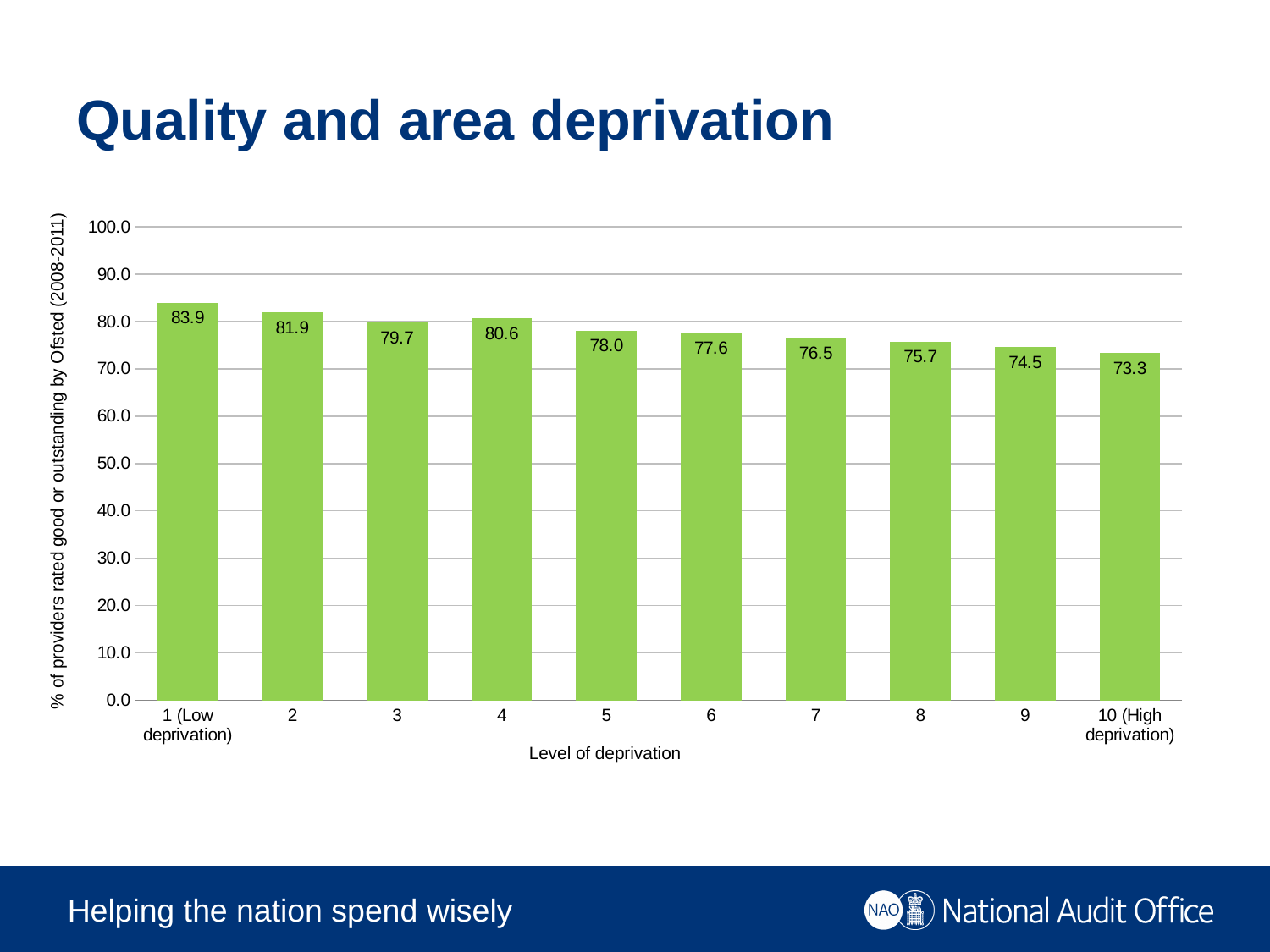
Is the value for deprivation level 8 greater or less than 80.0? less What kind of chart is shown on the slide? Bar chart What is the value for deprivation level 10 (High deprivation)? 73.3 Do the values generally rise or fall as the level of deprivation increases from 1 to 10? Fall Which level of deprivation has the highest percentage of providers rated good or outstanding? 1 (Low deprivation) What is the difference between the values for deprivation level 1 and deprivation level 10? 10.6 How many levels of deprivation are shown on the x axis? 10 What is the value for deprivation level 5? 78.0 Which level of deprivation has the lowest percentage of providers rated good or outstanding? 10 (High deprivation) What is the title of the slide? Quality and area deprivation What is the value for deprivation level 1 (Low deprivation)? 83.9 Which is larger, the value for deprivation level 3 or deprivation level 4? Level 4